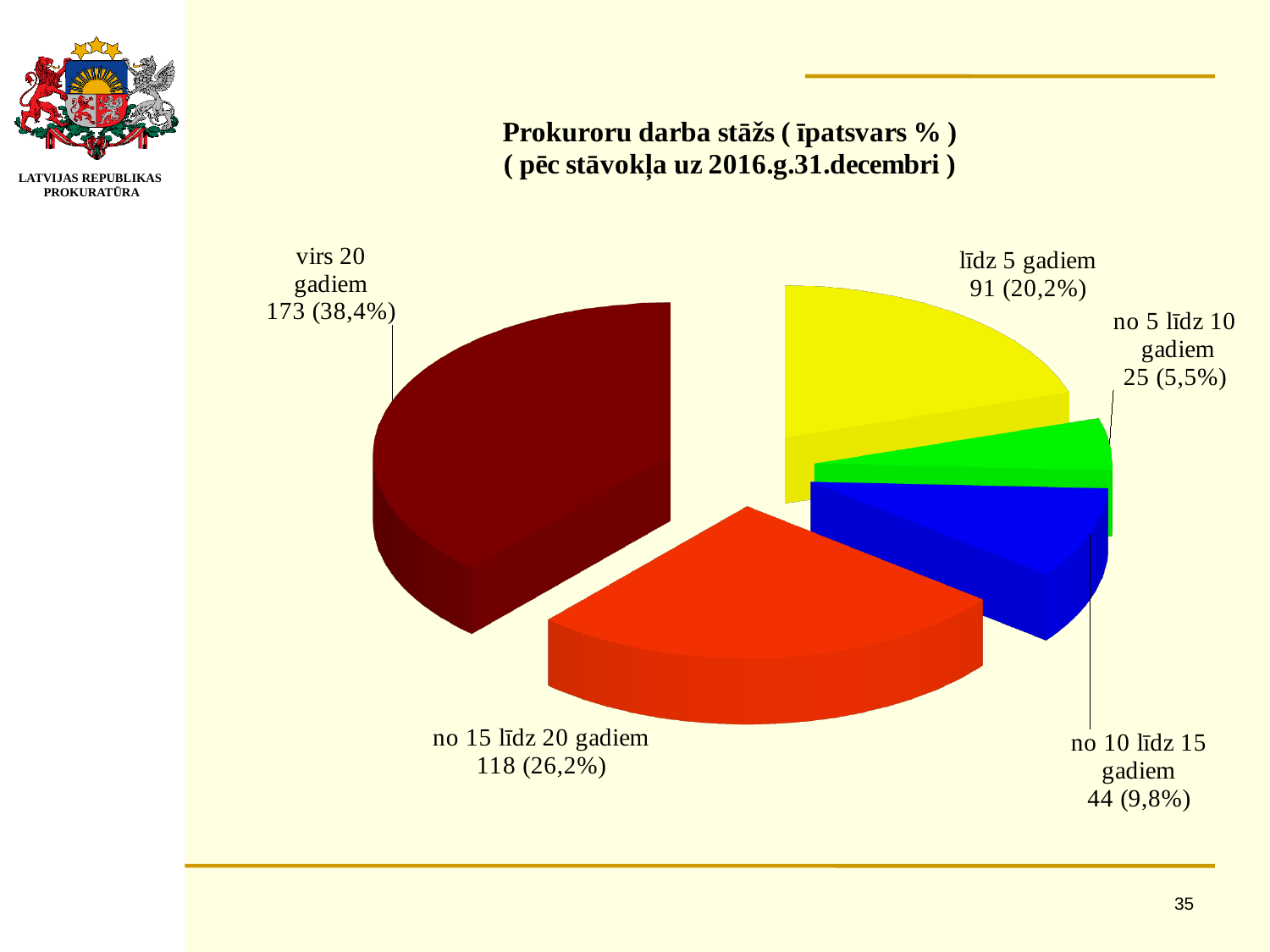
Which category has the largest slice of the pie? virs 20 gadiem How many slices does the pie chart have? 5 Which is larger, the count for "līdz 5 gadiem" or for "no 10 līdz 15 gadiem"? līdz 5 gadiem What colour is the slice for "no 15 līdz 20 gadiem"? red Which category has the smallest slice of the pie? no 5 līdz 10 gadiem What is the value shown for "no 10 līdz 15 gadiem"? 44 (9,8%) What is the value shown for "līdz 5 gadiem"? 91 (20,2%) What share of the pie does "no 15 līdz 20 gadiem" represent? 26,2% What kind of chart is shown on the slide? pie chart What share of the pie does "no 5 līdz 10 gadiem" represent? 5,5% What is the difference in count between "virs 20 gadiem" and "no 15 līdz 20 gadiem"? 55 What is the value shown for "virs 20 gadiem"? 173 (38,4%)